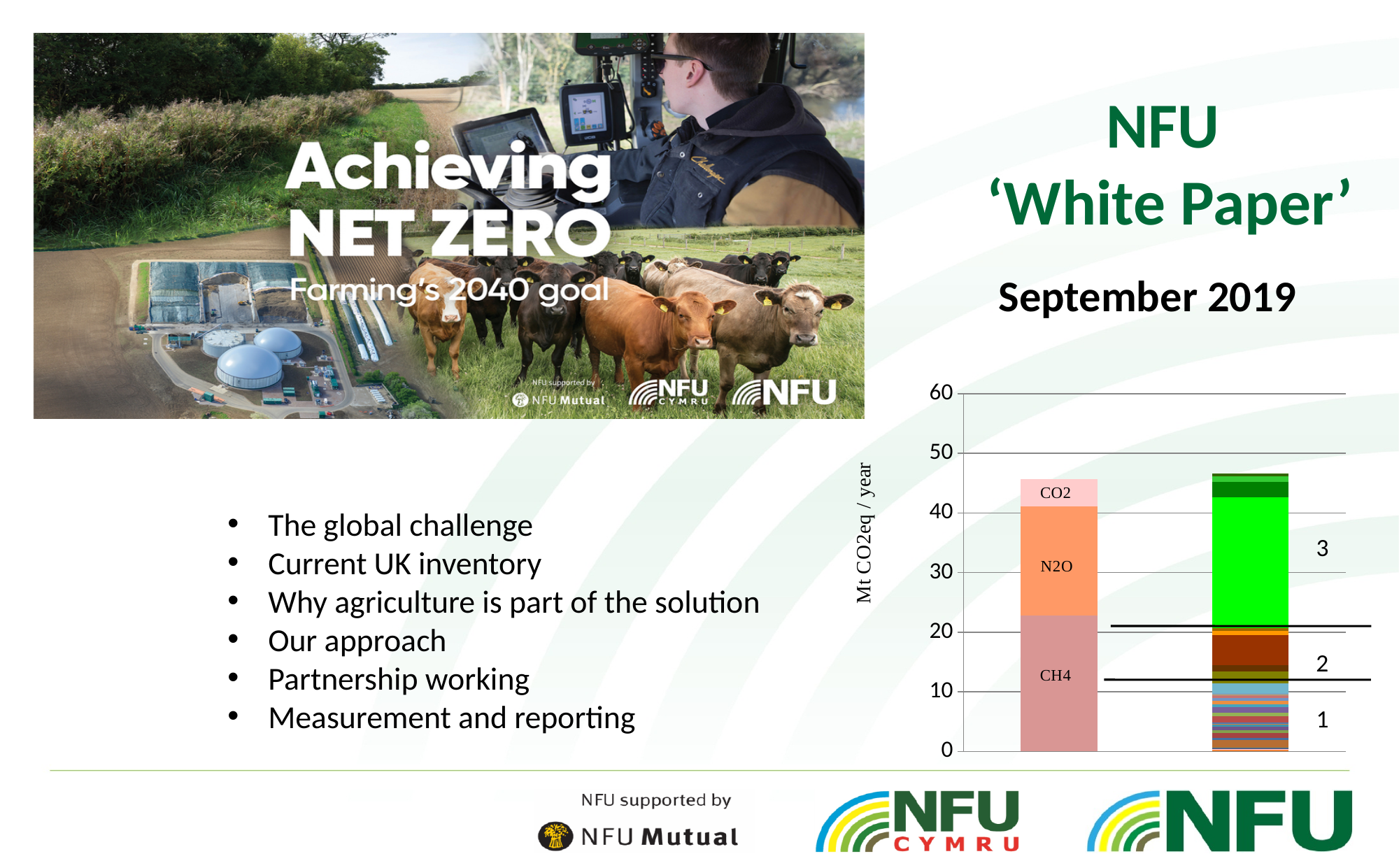
Is the CH4 segment of the left-hand bar larger or smaller than the N2O segment? larger Which three gases are labelled as segments of the left-hand bar? CH4, N2O, CO2 Is the total height of the right-hand bar greater or less than 40? greater What kind of chart is shown on the slide? Stacked bar chart What is the highest value shown on the vertical axis? 60 Which segment of the left-hand bar is the smallest? CO2 Is the top of group 2 in the right-hand bar greater or less than 30 on the vertical axis? less Which segment of the left-hand bar is the largest? CH4 Is the top of the CH4 segment in the left-hand bar greater or less than 20 on the vertical axis? greater What is the label on the vertical axis of the chart? Mt CO2eq / year How many bars are plotted in the chart? 2